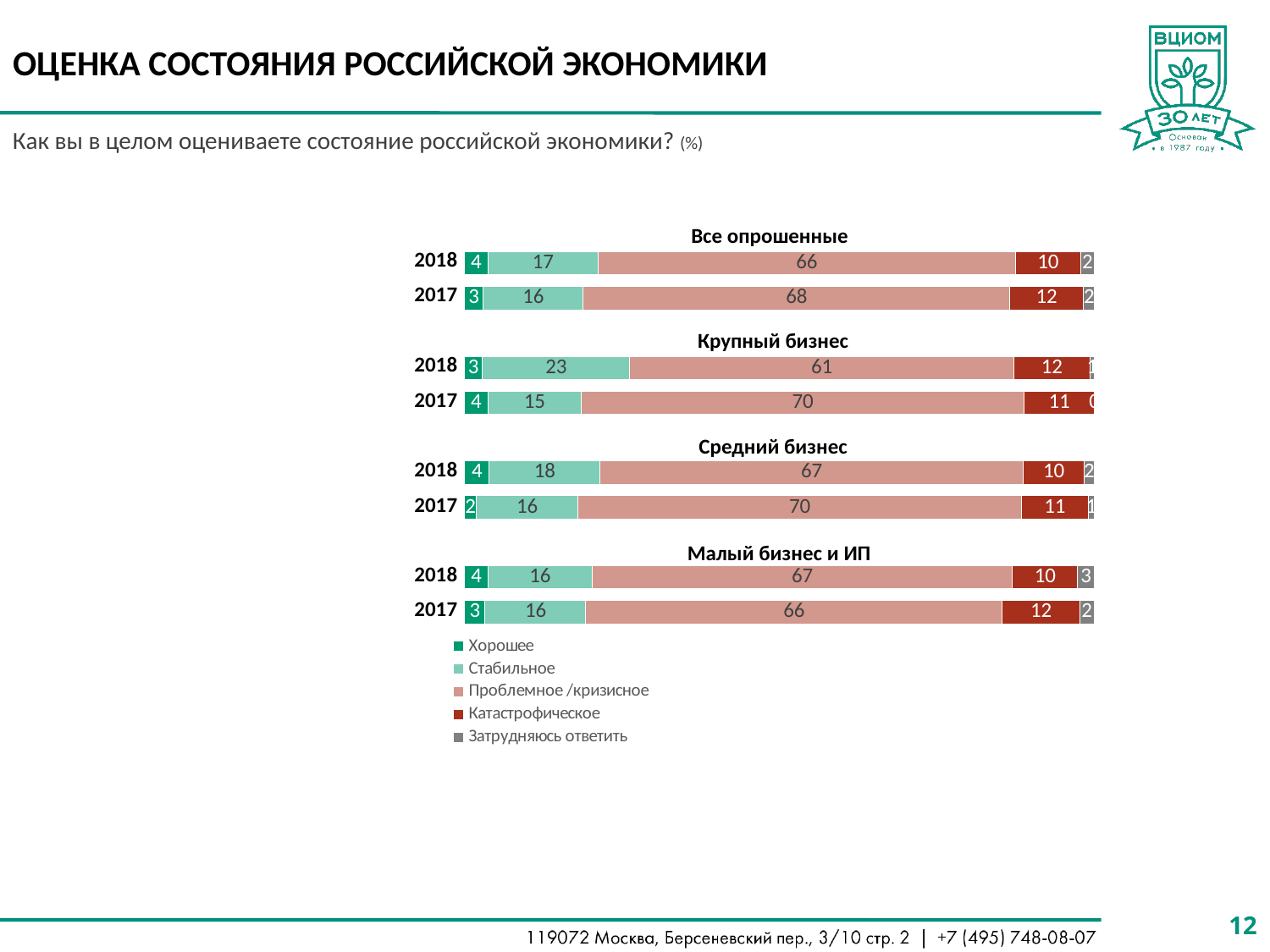
In the 'Все опрошенные' chart, which year has the larger 'Проблемное /кризисное' value, 2018 or 2017? 2017 In the 'Малый бизнес и ИП' chart, what is the total of the 2018 bar? 100 In the 'Средний бизнес' chart, what is the value for 'Хорошее' in 2017? 2 In the 'Все опрошенные' chart, what is the value for 'Катастрофическое' in 2017? 12 How many series does the legend list? 5 In the 'Крупный бизнес' chart, what is the value for 'Стабильное' in 2018? 23 In the 'Крупный бизнес' chart, what is the value for 'Проблемное /кризисное' in 2017? 70 What kind of chart is used on this slide? Stacked bar chart In the 'Малый бизнес и ИП' chart, what is the value for 'Затрудняюсь ответить' in 2018? 3 In the 'Все опрошенные' chart, what is the value for 'Проблемное /кризисное' in 2018? 66 In the 'Средний бизнес' chart, which series has the highest value in 2018? Проблемное /кризисное In the 'Крупный бизнес' chart, what is the difference between the 'Стабильное' values for 2018 and 2017? 8